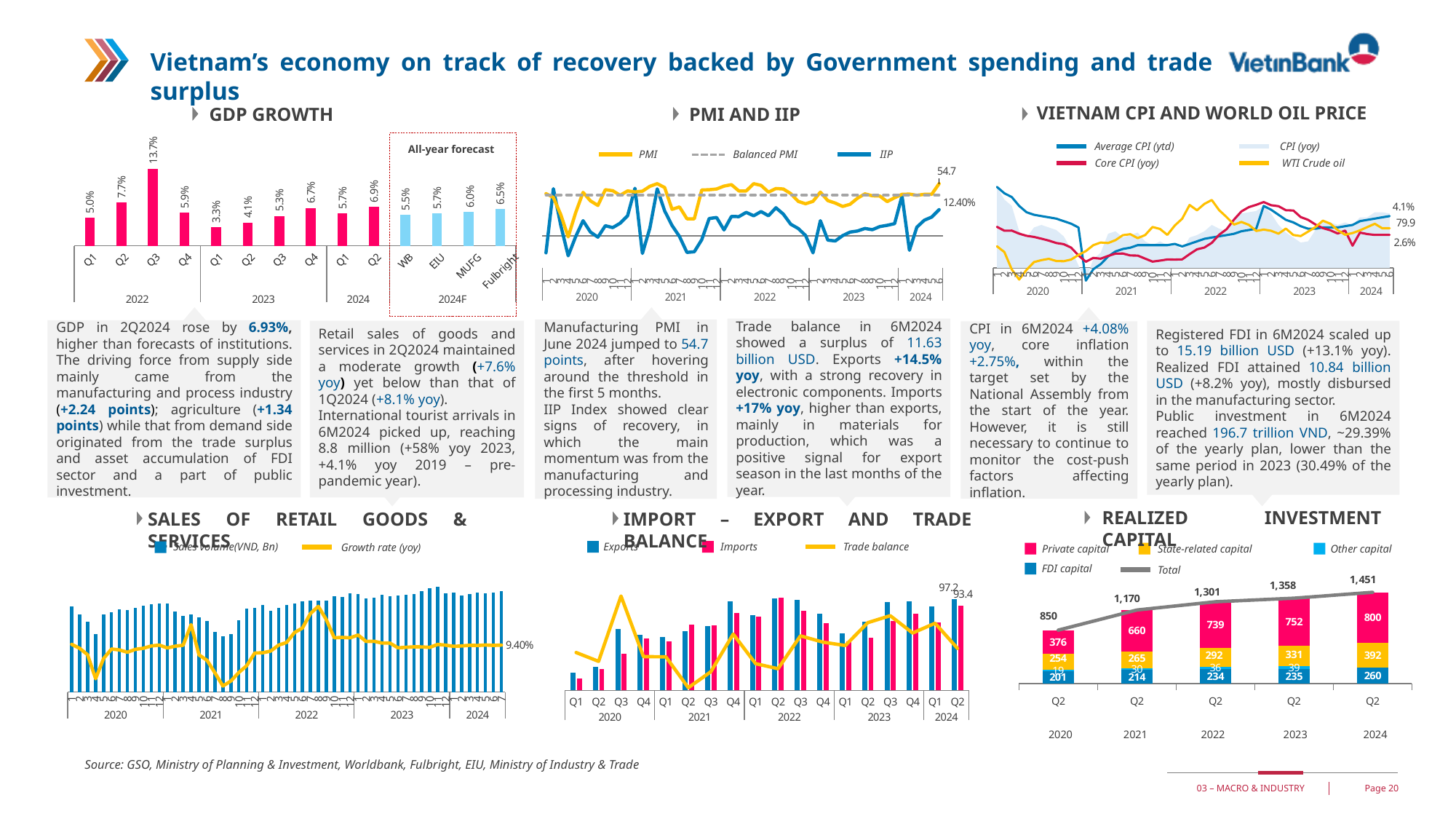
In the GDP GROWTH chart, what is the all-year 2024 forecast from Fulbright? 6.5% In the GDP GROWTH chart, which is larger: the WB forecast or the MUFG forecast for 2024? MUFG In the GDP GROWTH chart, which quarter has the lowest GDP growth? Q1 2023 In the GDP GROWTH chart, which quarter has the highest GDP growth? Q3 2022 In the REALIZED INVESTMENT CAPITAL chart, what is the private capital value for Q2 2022? 739 How many series does the legend of the PMI AND IIP chart list? 3 In the GDP GROWTH chart, what is the GDP growth value for Q3 2022? 13.7% In the REALIZED INVESTMENT CAPITAL chart, what is the difference between the FDI capital values for Q2 2024 and Q2 2020? 59 In the REALIZED INVESTMENT CAPITAL chart, what is the total for Q2 2024? 1,451 What kind of chart is the REALIZED INVESTMENT CAPITAL chart? Stacked bar chart In the GDP GROWTH chart, what is the difference between the Q2 2024 value and the Q1 2024 value? 1.2 percentage points In the VIETNAM CPI AND WORLD OIL PRICE chart, what is the latest labelled value for WTI Crude oil? 79.9